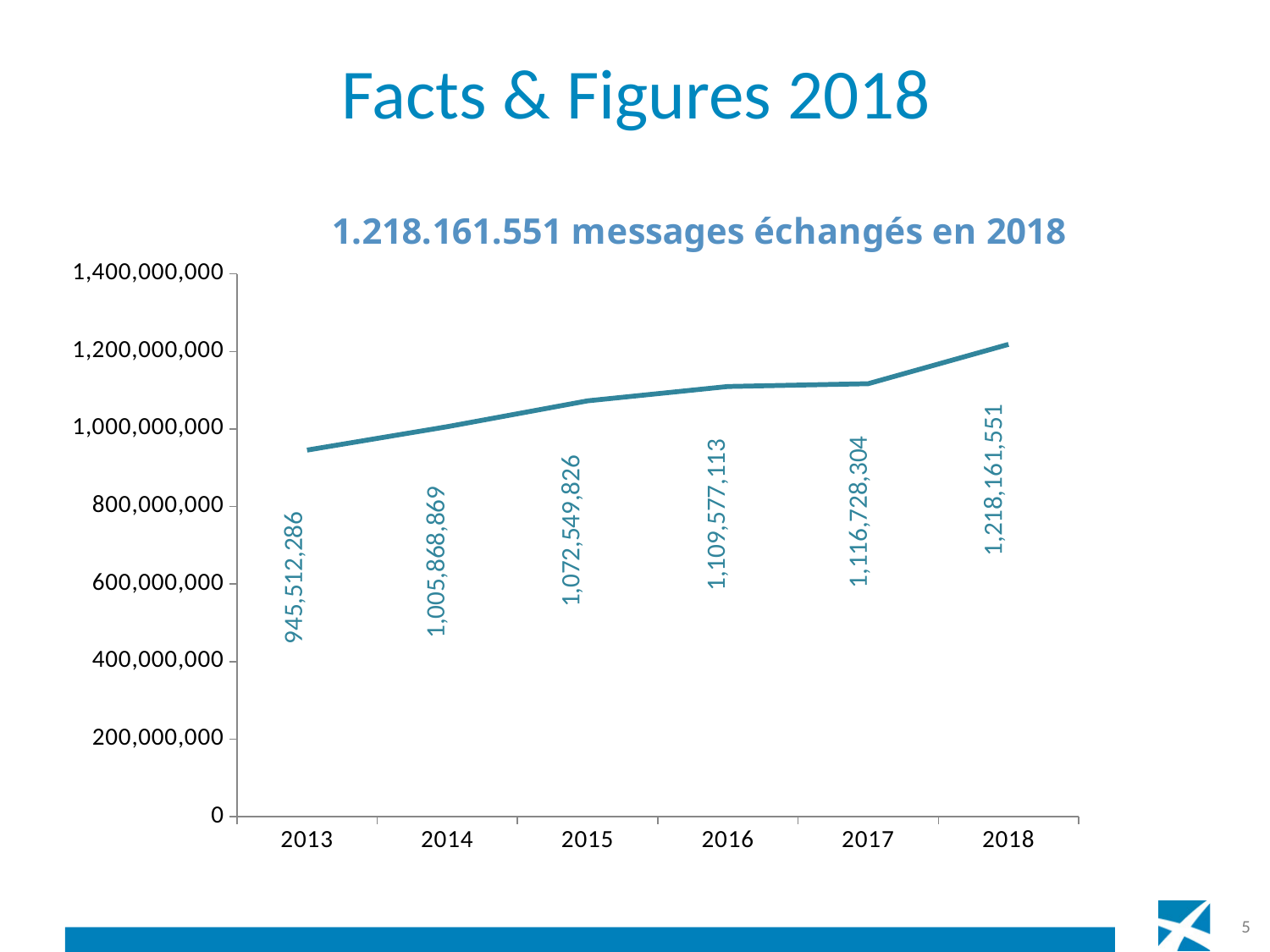
What is the value for 2016? 1,109,577,113 What is the value for 2013? 945,512,286 Do the values rise or fall from 2013 to 2018? rise How many years are plotted on the x axis? 6 What is the difference between the values for 2018 and 2017? 101,433,247 Which year has the highest value? 2018 Is the value for 2013 greater or less than 1,000,000,000? less What kind of chart is shown on the slide? line chart Which year has the lowest value? 2013 Which is larger, the value for 2015 or the value for 2017? 2017 What is the value for 2018? 1,218,161,551 What is the difference between the values for 2014 and 2013? 60,356,583